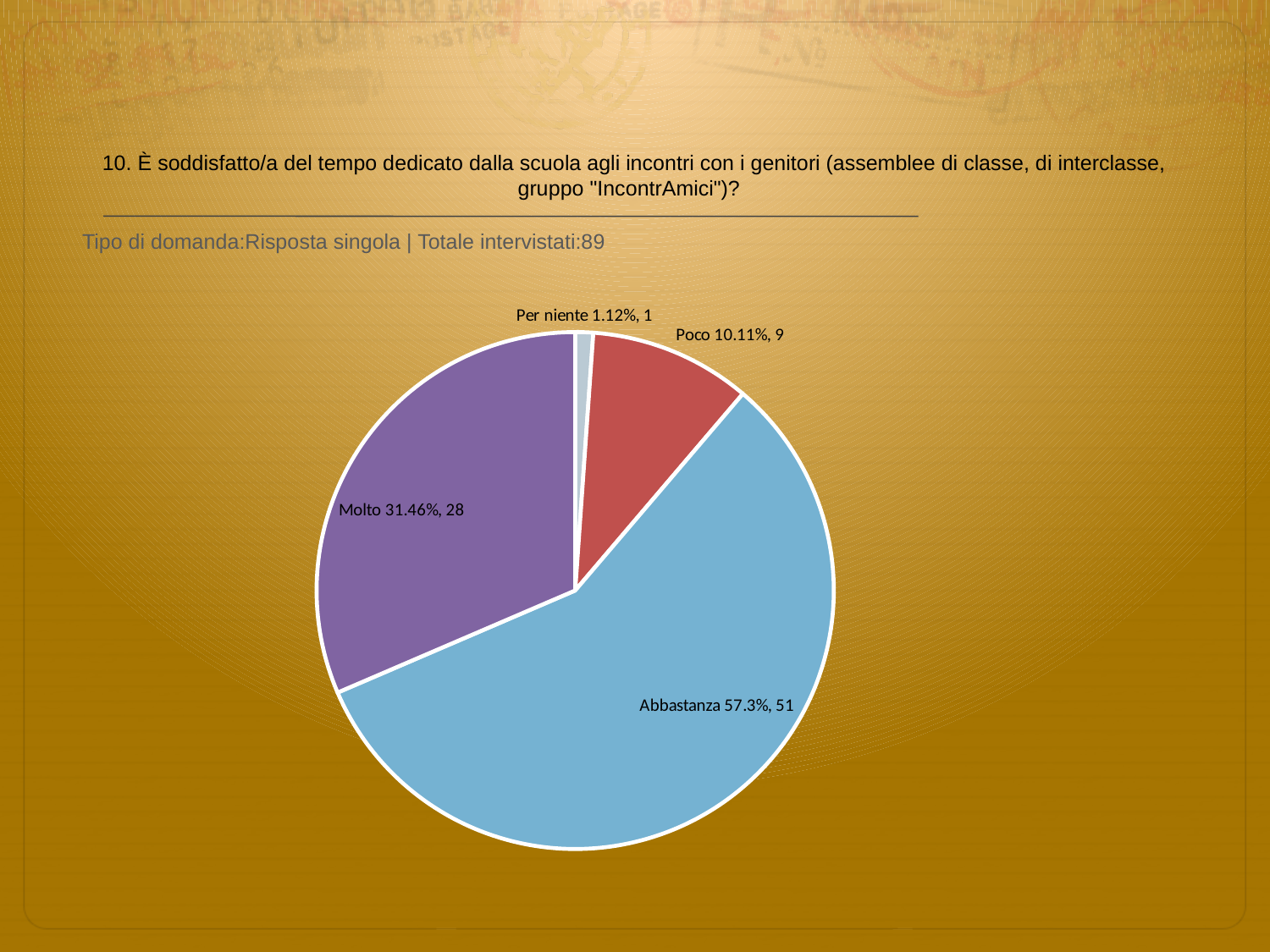
What is the total number of respondents shown in the pie chart? 89 What kind of chart is shown on the slide? pie chart What percentage share does the "Poco" slice have? 10.11% What percentage share does the "Abbastanza" slice have? 57.3% Which has more respondents, "Poco" or "Molto"? Molto Which response category has the smallest slice? Per niente What is the difference in number of respondents between "Abbastanza" and "Molto"? 23 How many respondents answered "Molto"? 28 What colour is the "Molto" slice? purple How many slices does the pie chart have? 4 How many respondents answered "Per niente"? 1 Which response category has the largest slice? Abbastanza